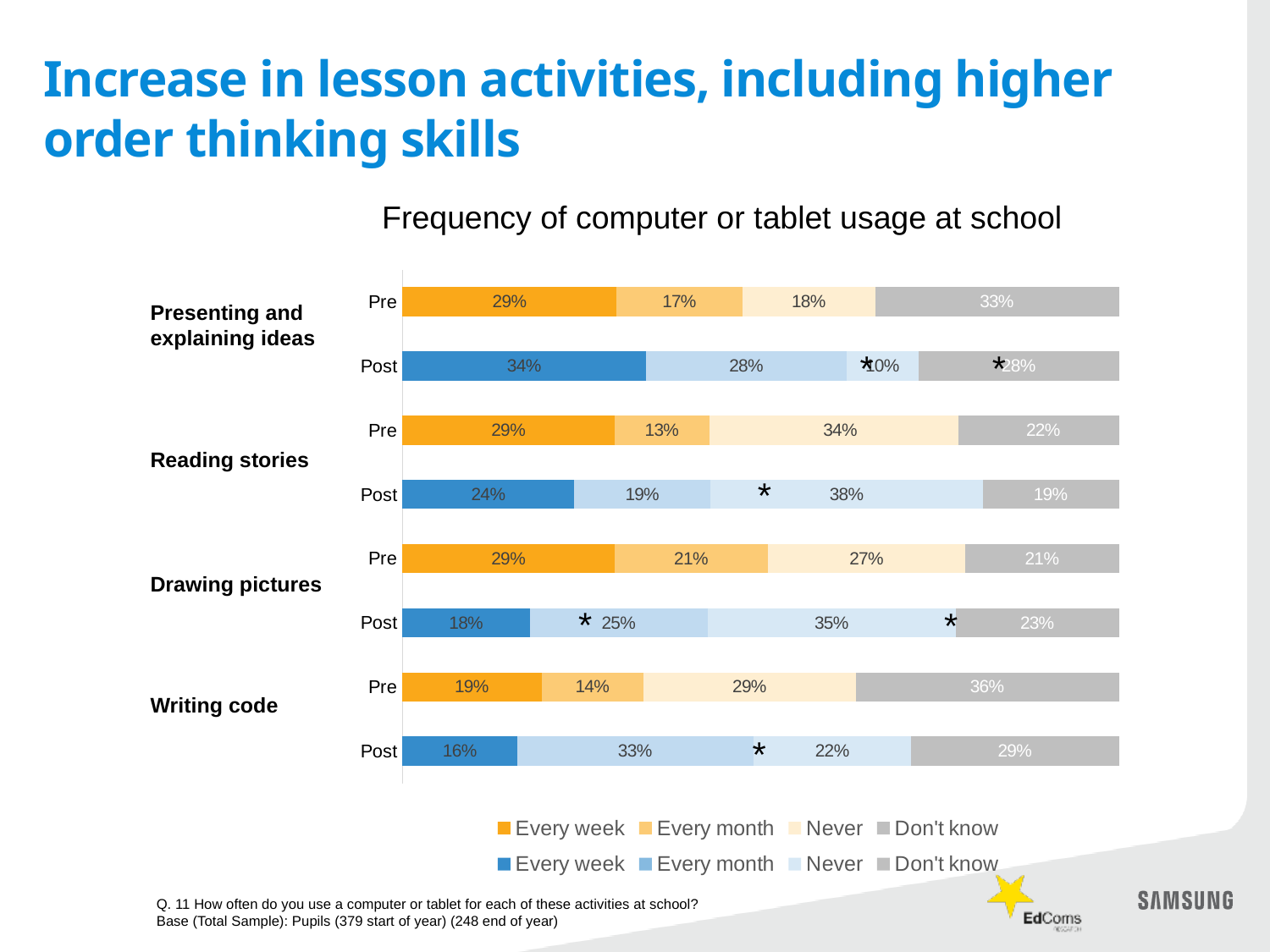
What is the difference between the Pre and Post 'Every month' values for Writing code? 19 percentage points Which activity has the lowest 'Every week' value in the Post survey? Writing code What is the 'Every month' value for Drawing pictures in the Post survey? 25% How many activities are shown on the chart? 4 Is the 'Every week' value for Drawing pictures larger in the Pre or the Post survey? Pre What type of chart is shown on the slide? Stacked bar chart Which activity has the highest 'Every week' value in the Post survey? Presenting and explaining ideas What is the chart's title? Frequency of computer or tablet usage at school What percentage of pupils said they use a computer or tablet every week for Writing code in the Pre survey? 19% What is the total of the Pre bar for Reading stories? 98% What is the 'Never' value for Reading stories in the Post survey? 38% What is the 'Don't know' value for Writing code in the Pre survey? 36%